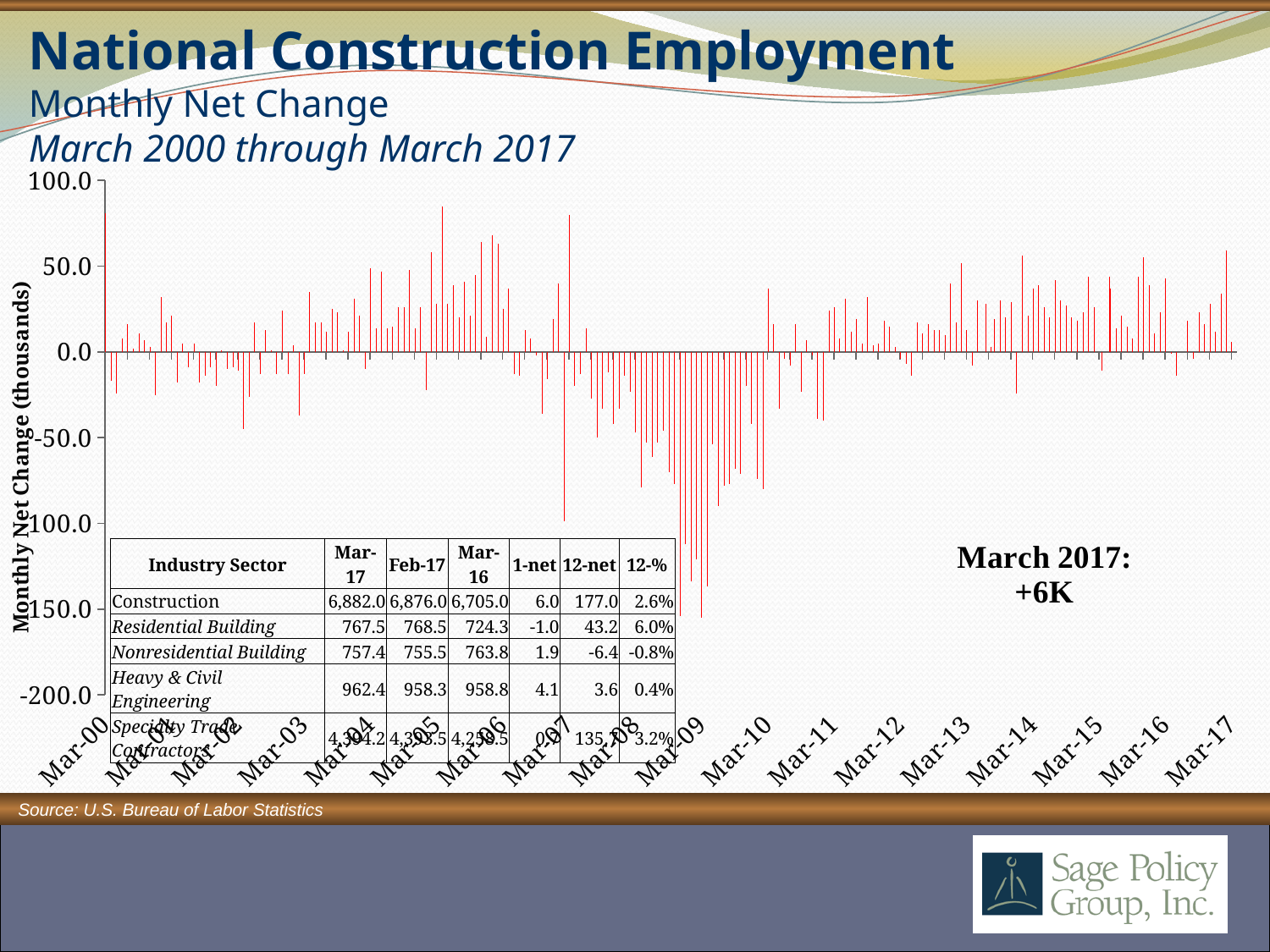
In the table on the chart, which is larger: the Mar-17 value for Residential Building or for Nonresidential Building? Residential Building In which year does the chart show the largest monthly job losses? 2009 In the table on the chart, what is the Mar-17 value for Construction? 6,882.0 According to the annotation on the chart, what was the net change in construction employment in March 2017? +6K Is the lowest bar on the chart, near Mar-09, greater or less than -100? less In the table on the chart, what is the 12-% value for Residential Building? 6.0% Do the monthly net change values generally rise or fall from Mar-09 to Mar-17? rise What kind of chart is shown on the slide? bar chart How many month labels are shown along the x axis of the chart? 18 What is the title of the chart on the slide? National Construction Employment What is the label on the vertical axis of the chart? Monthly Net Change (thousands) Is the value for the first bar (Mar-00) greater or less than 50? greater